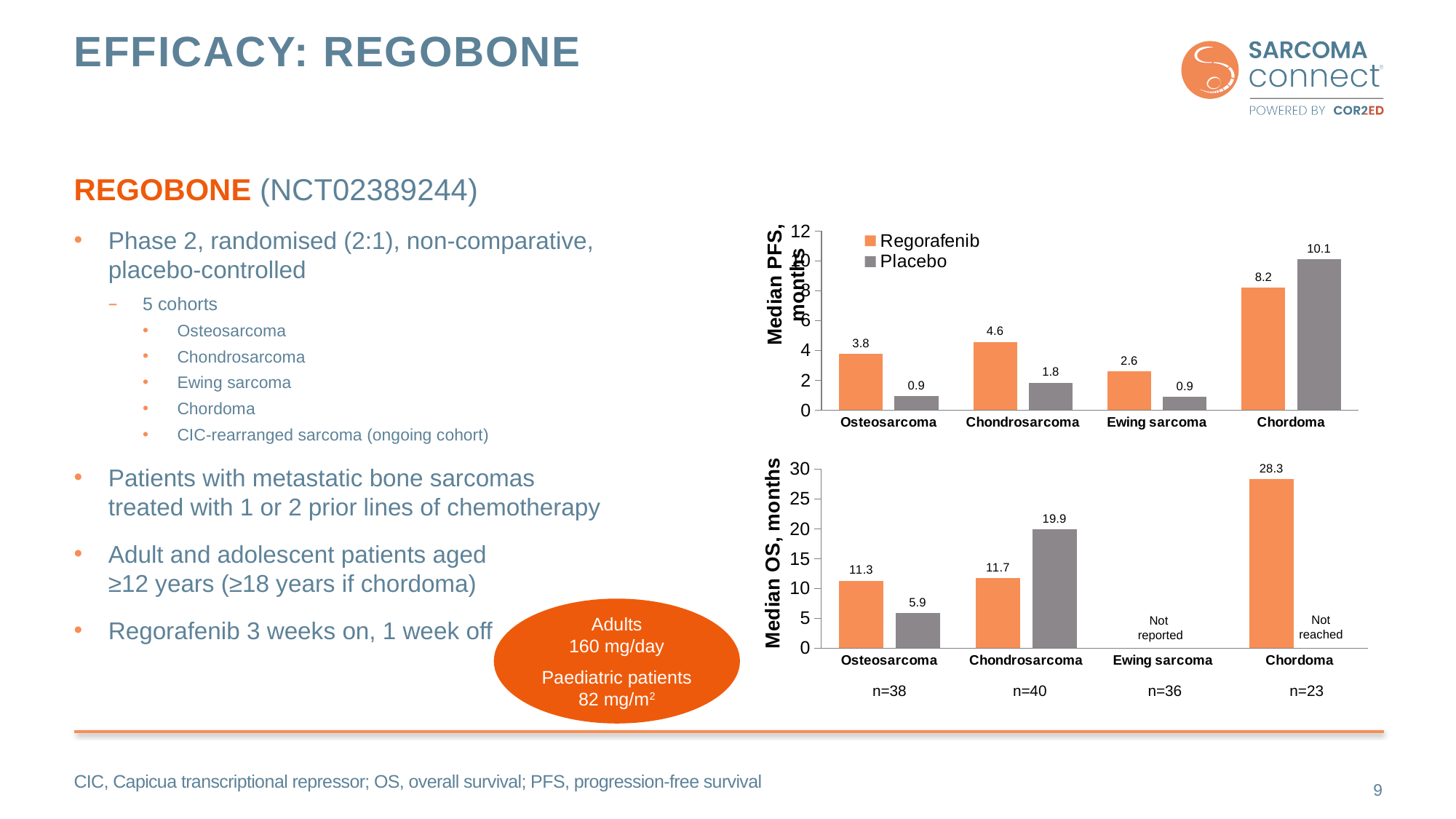
In the Median PFS chart (top), which is larger in the Chordoma cohort: the Regorafenib or the Placebo median PFS? Placebo In the Median PFS chart (top), what is the median PFS for Placebo in the Chordoma cohort? 10.1 In the Median OS chart (bottom), what is the difference between the Regorafenib and Placebo median OS in the Osteosarcoma cohort? 5.4 In the Median PFS chart (top), what is the median PFS for Regorafenib in the Chondrosarcoma cohort? 4.6 In the Median PFS chart (top), what is the difference between the Regorafenib and Placebo median PFS in the Osteosarcoma cohort? 2.9 How many series does the legend of the Median PFS chart (top) list? 2 In the Median OS chart (bottom), what is the median OS for Placebo in the Chondrosarcoma cohort? 19.9 In the Median PFS chart (top), which cohort has the lowest Regorafenib median PFS? Ewing sarcoma In the Median PFS chart (top), which cohort has the highest Regorafenib median PFS? Chordoma What type of chart is the Median OS chart (bottom)? Bar chart In the Median OS chart (bottom), what is the median OS for Regorafenib in the Chordoma cohort? 28.3 In the Median OS chart (bottom), what is shown for the Ewing sarcoma cohort instead of bars? Not reported